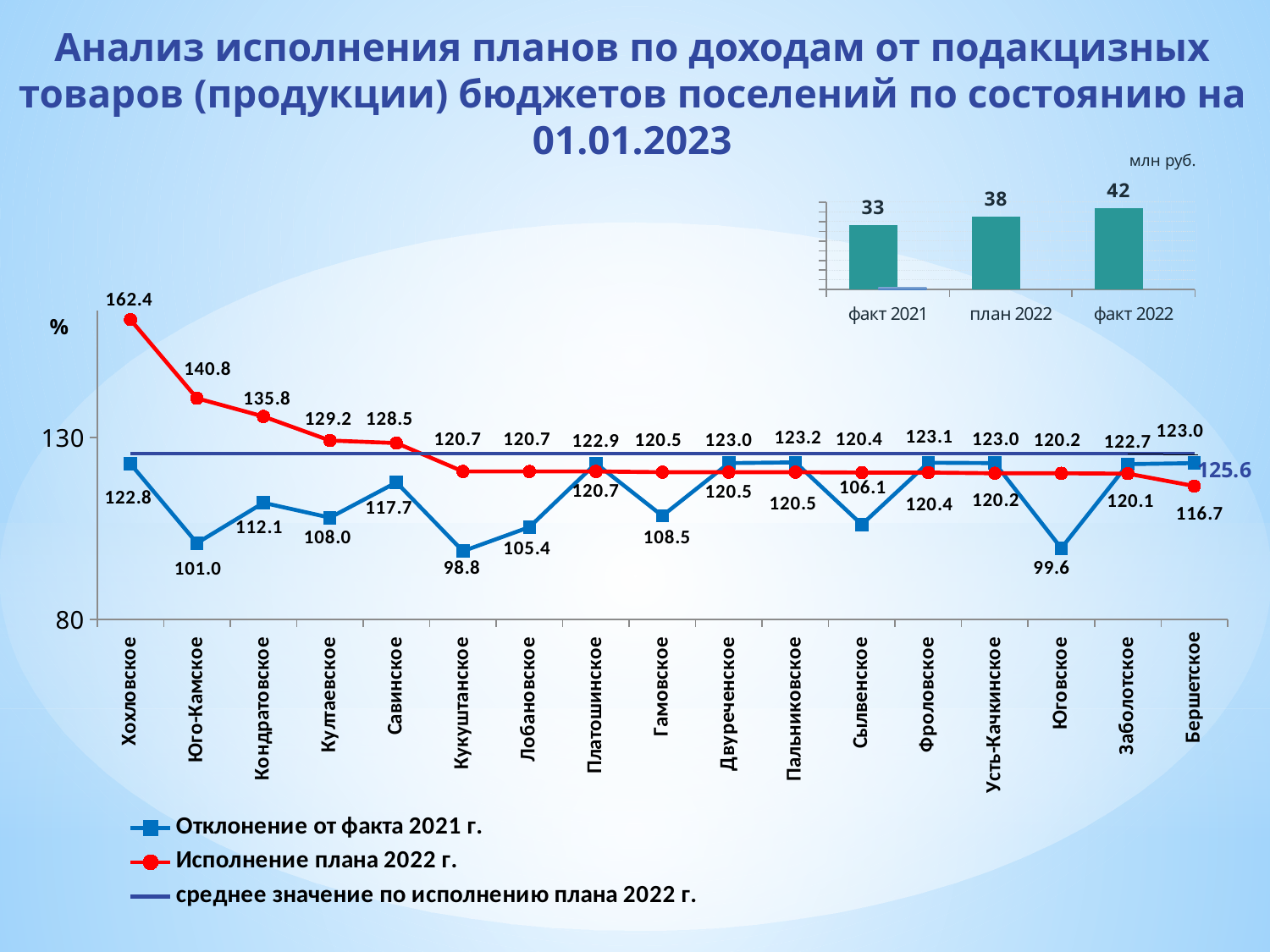
In the small bar chart at the top right, how many bars are shown? 3 In the small bar chart at the top right, what is the value for факт 2022? 42 What kind of chart is the small chart at the top right of the slide? bar chart In the large line chart, what is the value of the line среднее значение по исполнению плана 2022 г.? 125.6 In the large line chart, how many settlements are shown on the x axis? 17 In the large line chart, what is the value of Отклонение от факта 2021 г. for Юго-Камское? 101.0 In the small bar chart at the top right, which category has the highest value? факт 2022 In the small bar chart at the top right, what is the difference between факт 2022 and факт 2021? 9 In the large line chart, what is the value of Исполнение плана 2022 г. for Хохловское? 162.4 In the large line chart, how many series does the legend list? 3 In the large line chart, which settlement has the lowest value of Отклонение от факта 2021 г.? Кукуштанское In the large line chart, which settlement has the highest value of Исполнение плана 2022 г.? Хохловское